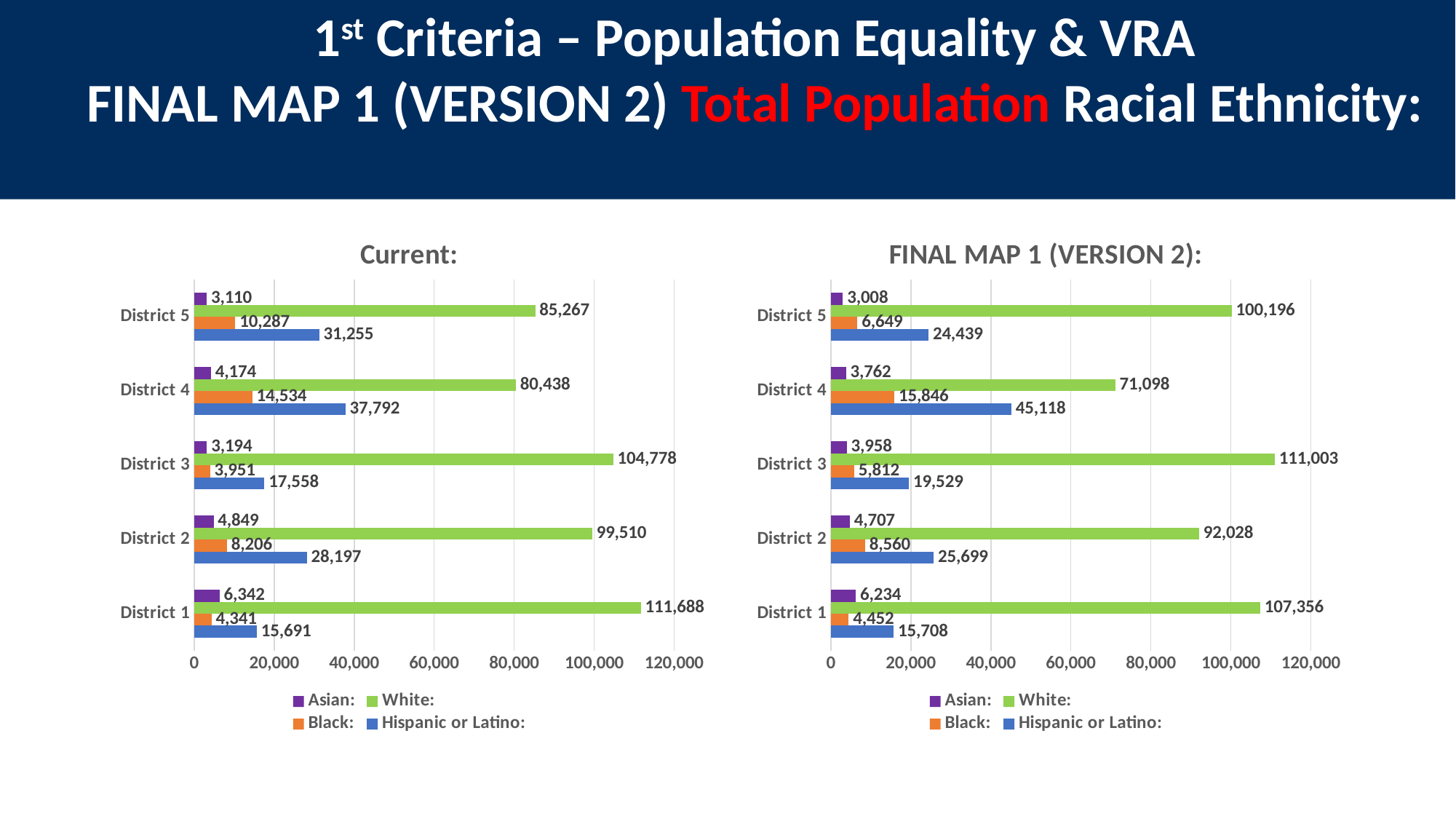
In the 'Current:' chart, what is the White population for District 3? 104,778 What type of chart is the 'Current:' chart? Bar chart In the 'FINAL MAP 1 (VERSION 2):' chart, which colour represents the Asian series? Purple In the 'Current:' chart, which district has the highest White population? District 1 In the 'FINAL MAP 1 (VERSION 2):' chart, what is the Black population for District 5? 6,649 In the 'Current:' chart, what is the difference between the Hispanic or Latino populations of District 4 and District 1? 22,101 In the 'FINAL MAP 1 (VERSION 2):' chart, what is the Hispanic or Latino population for District 4? 45,118 In the 'FINAL MAP 1 (VERSION 2):' chart, which is larger: the White population of District 2 or District 4? District 2 How many districts are shown in the 'FINAL MAP 1 (VERSION 2):' chart? 5 How many series does the legend of the 'Current:' chart list? 4 In the 'Current:' chart, is the White population for District 5 greater or less than 80,000? greater In the 'FINAL MAP 1 (VERSION 2):' chart, which district has the lowest Hispanic or Latino population? District 1